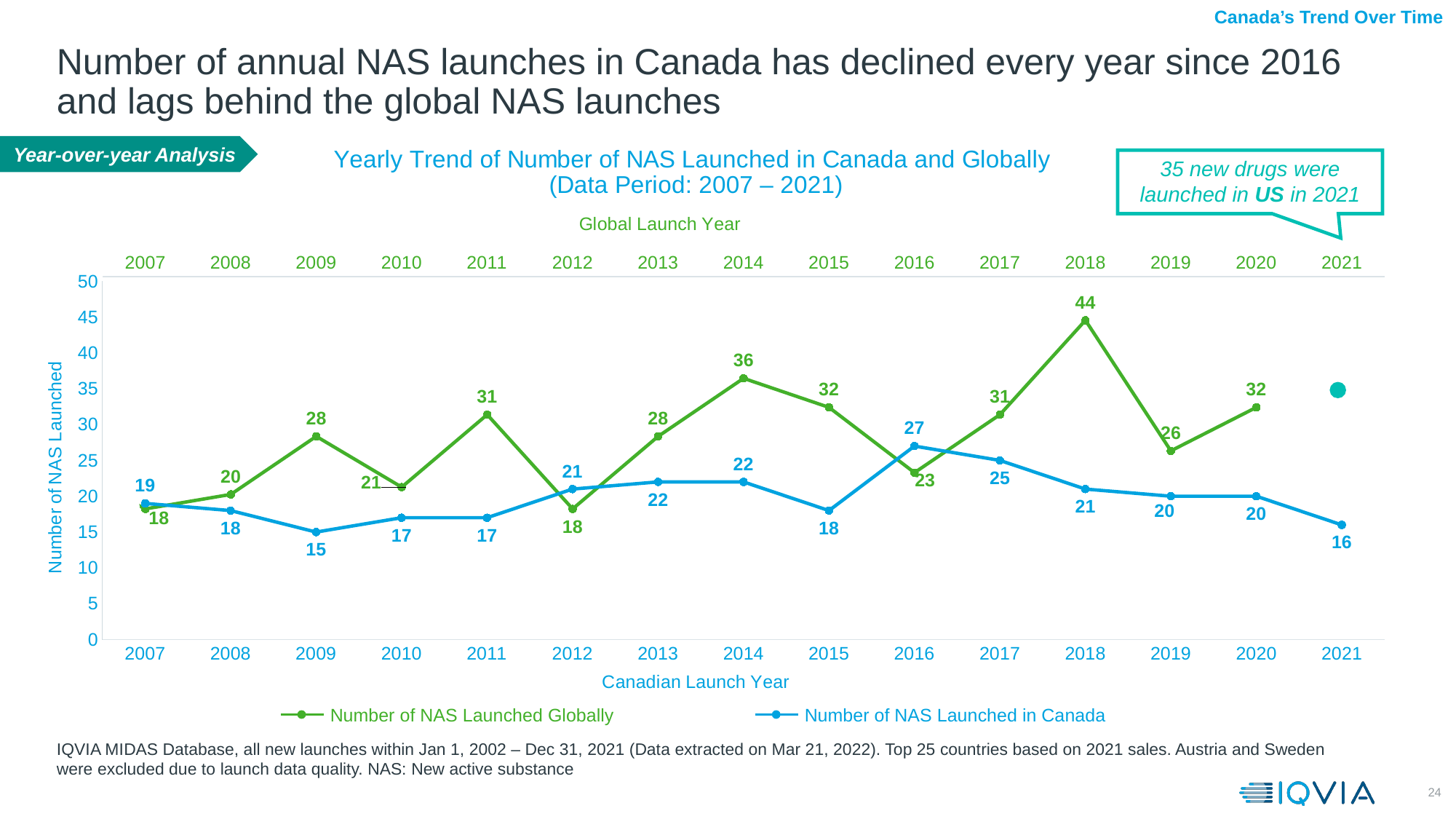
What is the difference between the number of NAS launched globally and in Canada in 2018? 23 What is the number of NAS launched globally in 2018? 44 In which year was the number of NAS launched in Canada lowest? 2009 What is the label of the y axis of the chart? Number of NAS Launched In which year was the number of NAS launched globally highest? 2018 Which was larger in 2016: the number of NAS launched globally or in Canada? Number of NAS Launched in Canada What is the number of NAS launched in Canada in 2016? 27 What kind of chart is shown on the slide? Line chart How many series does the legend list? 2 How many years are shown on the x axis of the chart? 15 What is the number of NAS launched in Canada in 2021? 16 Did the number of NAS launched in Canada rise or fall from 2016 to 2021? Fall